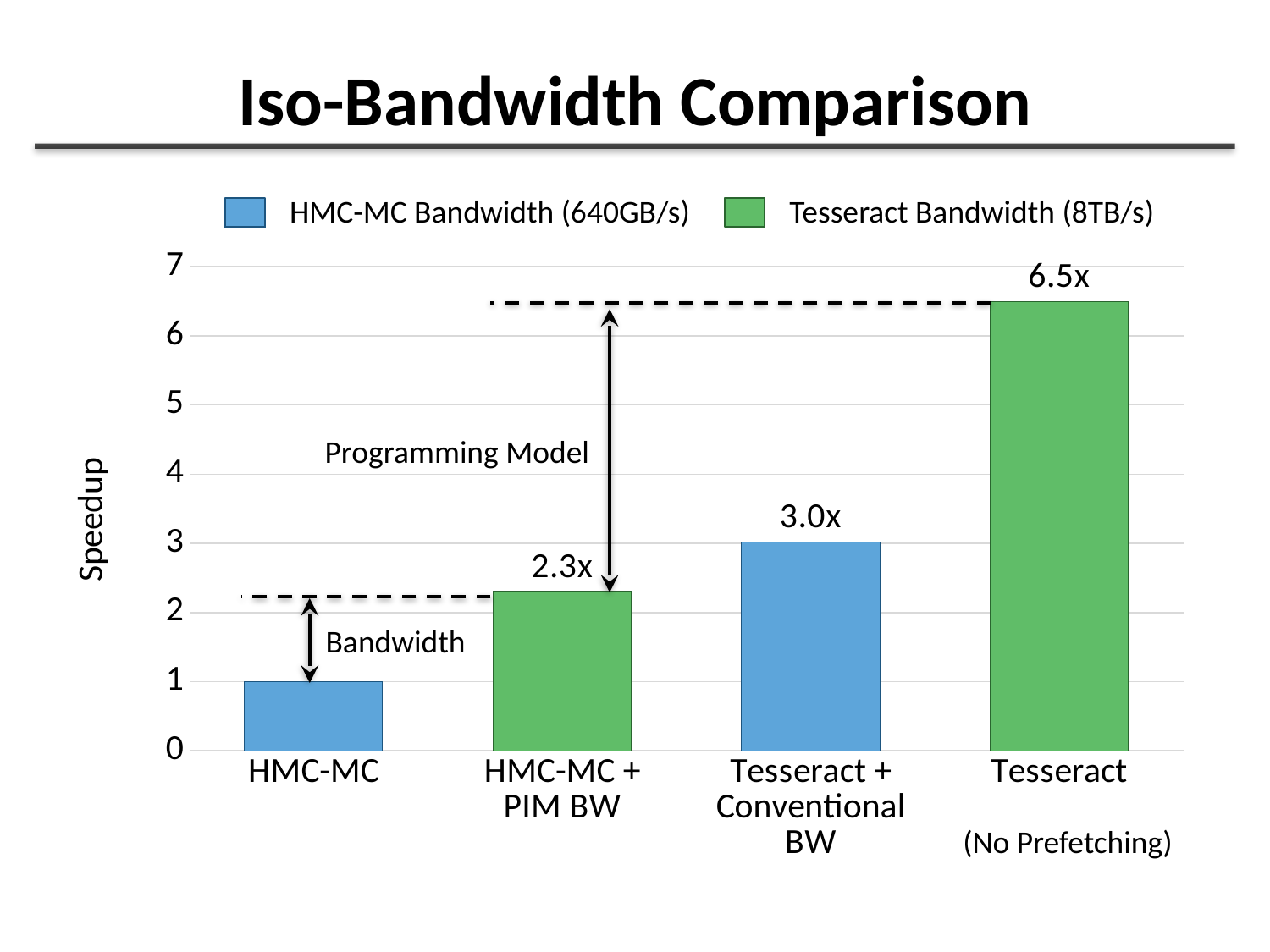
What is the speedup shown for HMC-MC + PIM BW? 2.3x How many configurations are shown on the x axis? 4 Is the speedup for HMC-MC greater or less than 2? less What is the difference in speedup between Tesseract and HMC-MC + PIM BW? 4.2x Which configuration has the lowest speedup? HMC-MC What is the speedup shown for Tesseract? 6.5x What kind of chart is shown on the slide? bar chart Which configuration has the highest speedup? Tesseract What is the difference in speedup between Tesseract + Conventional BW and HMC-MC + PIM BW? 0.7x How many series does the legend list? 2 What is the speedup shown for Tesseract + Conventional BW? 3.0x Which has a larger speedup, Tesseract + Conventional BW or HMC-MC + PIM BW? Tesseract + Conventional BW